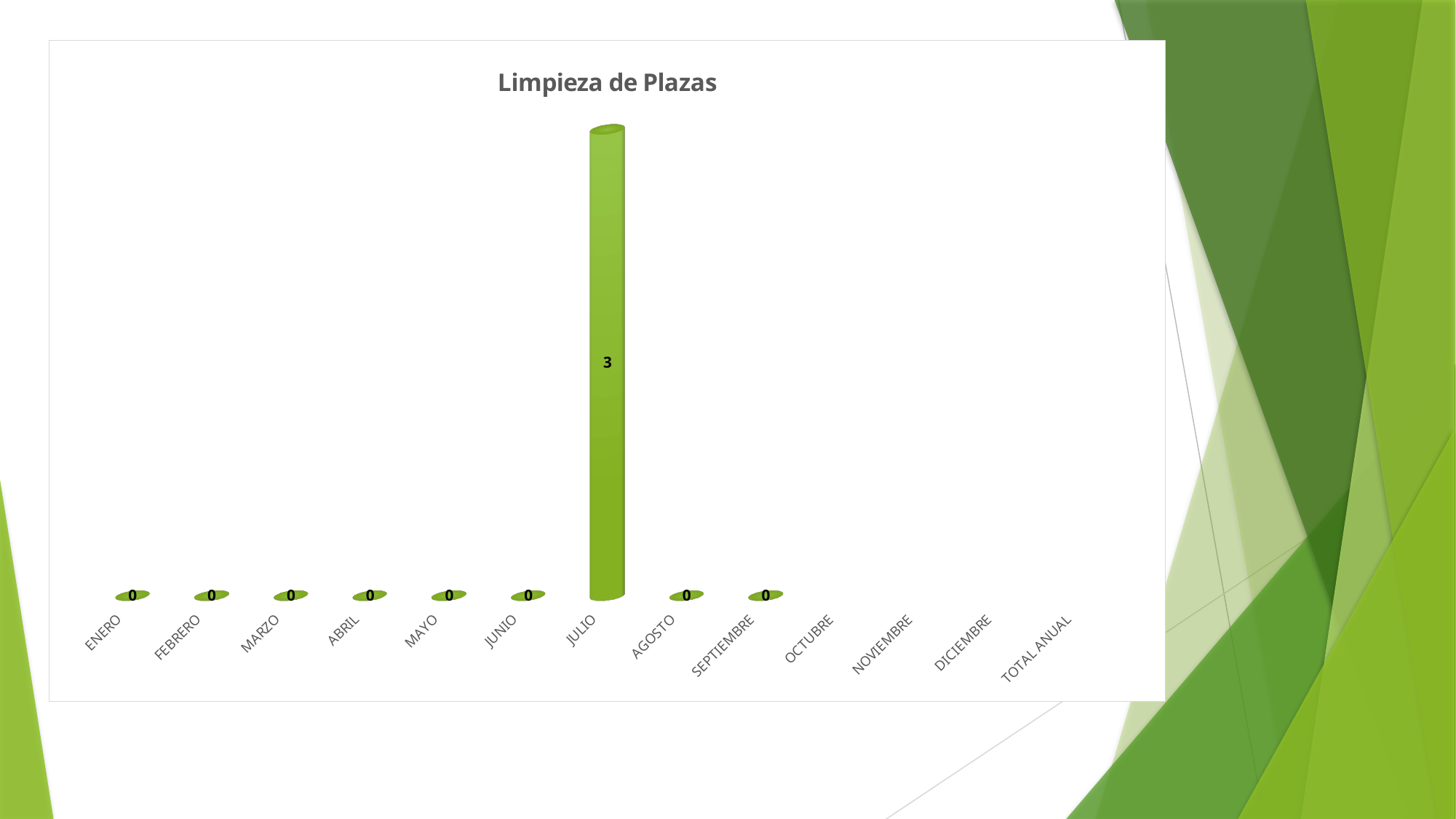
What is the value for ENERO? 0 What is the title of the chart? Limpieza de Plazas Which is larger, the value for JULIO or the value for MARZO? JULIO What colour are the bars in the chart? green How many category labels are shown on the x axis? 13 What is the difference between the values for JULIO and AGOSTO? 3 What is the value for ABRIL? 0 What is the value for JULIO? 3 What is the value for SEPTIEMBRE? 0 How many bars have a data label printed on the chart? 9 Which month has the highest value? JULIO What kind of chart is shown on the slide? bar chart